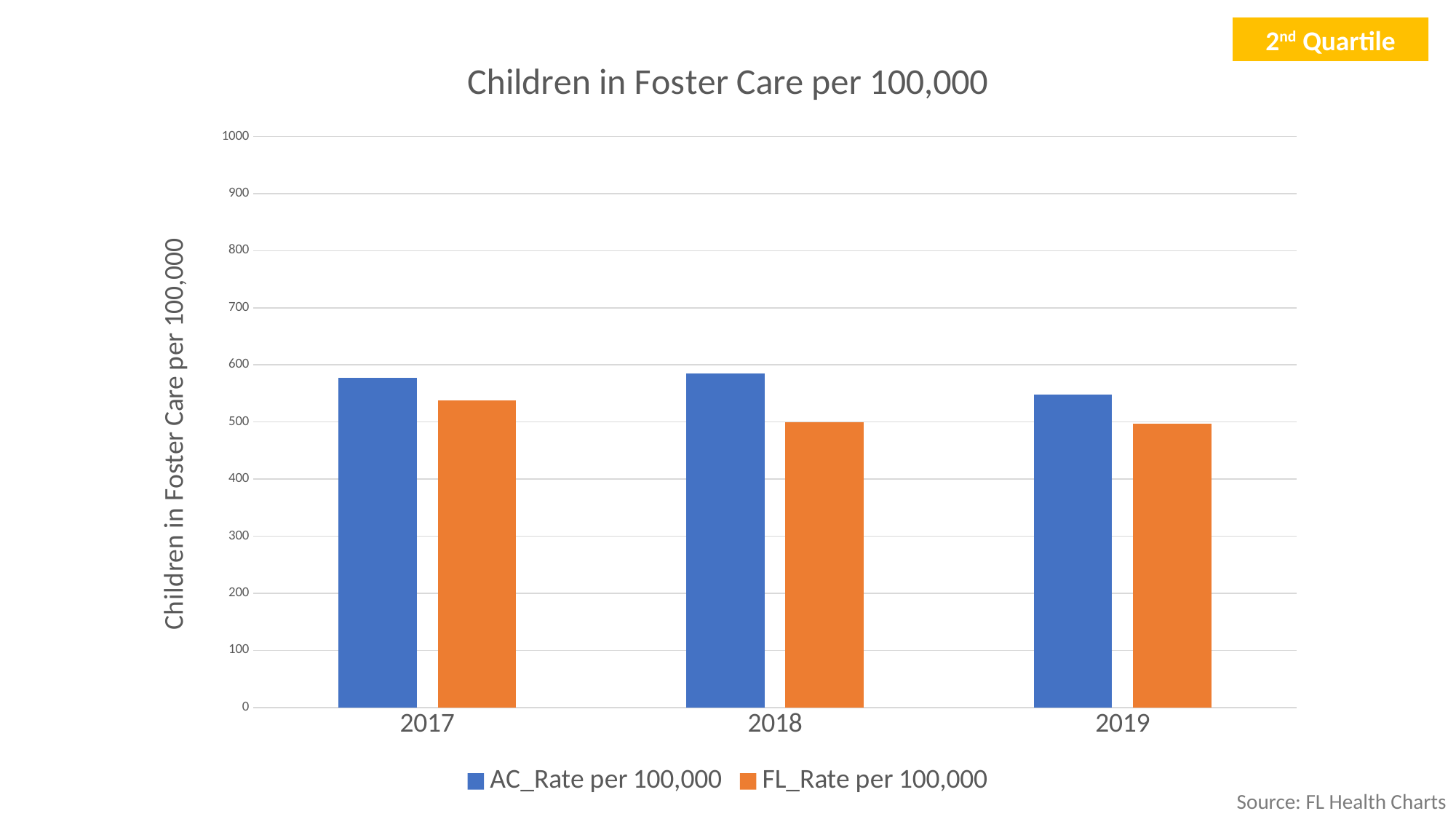
What kind of chart is shown on the slide? bar chart In 2019, which is larger, AC_Rate per 100,000 or FL_Rate per 100,000? AC_Rate per 100,000 Does FL_Rate per 100,000 rise or fall from 2017 to 2019? fall In 2017, which is larger, AC_Rate per 100,000 or FL_Rate per 100,000? AC_Rate per 100,000 How many series does the legend list? 2 Is the value for AC_Rate per 100,000 in 2017 greater or less than 600? less What is the title of the chart? Children in Foster Care per 100,000 How many years are shown on the x axis? 3 In 2018, which is larger, AC_Rate per 100,000 or FL_Rate per 100,000? AC_Rate per 100,000 Which series is shown in orange? FL_Rate per 100,000 In which year is AC_Rate per 100,000 lowest? 2019 In which year is FL_Rate per 100,000 highest? 2017